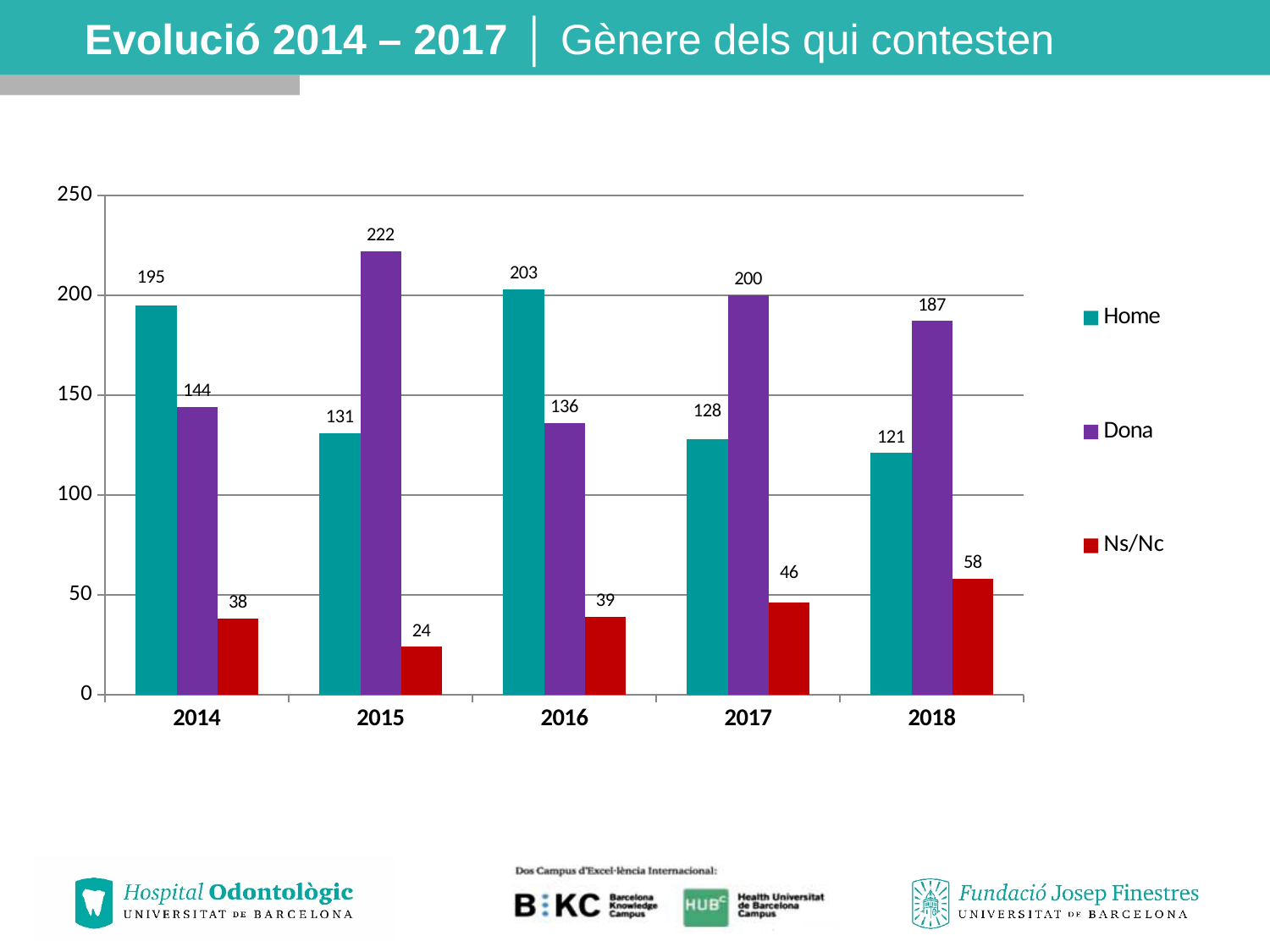
What is the value for Ns/Nc in 2018? 58 How many years are shown on the x axis? 5 What is the value for Dona in 2015? 222 Which is larger in 2016, Home or Dona? Home What colour are the Dona bars? purple What kind of chart is shown on the slide? bar chart In which year is the Dona value highest? 2015 How many series does the legend list? 3 In which year is the Ns/Nc value lowest? 2015 What is the value for Home in 2014? 195 Does the Ns/Nc value rise or fall from 2015 to 2018? rise What is the difference between the Dona and Home values in 2017? 72